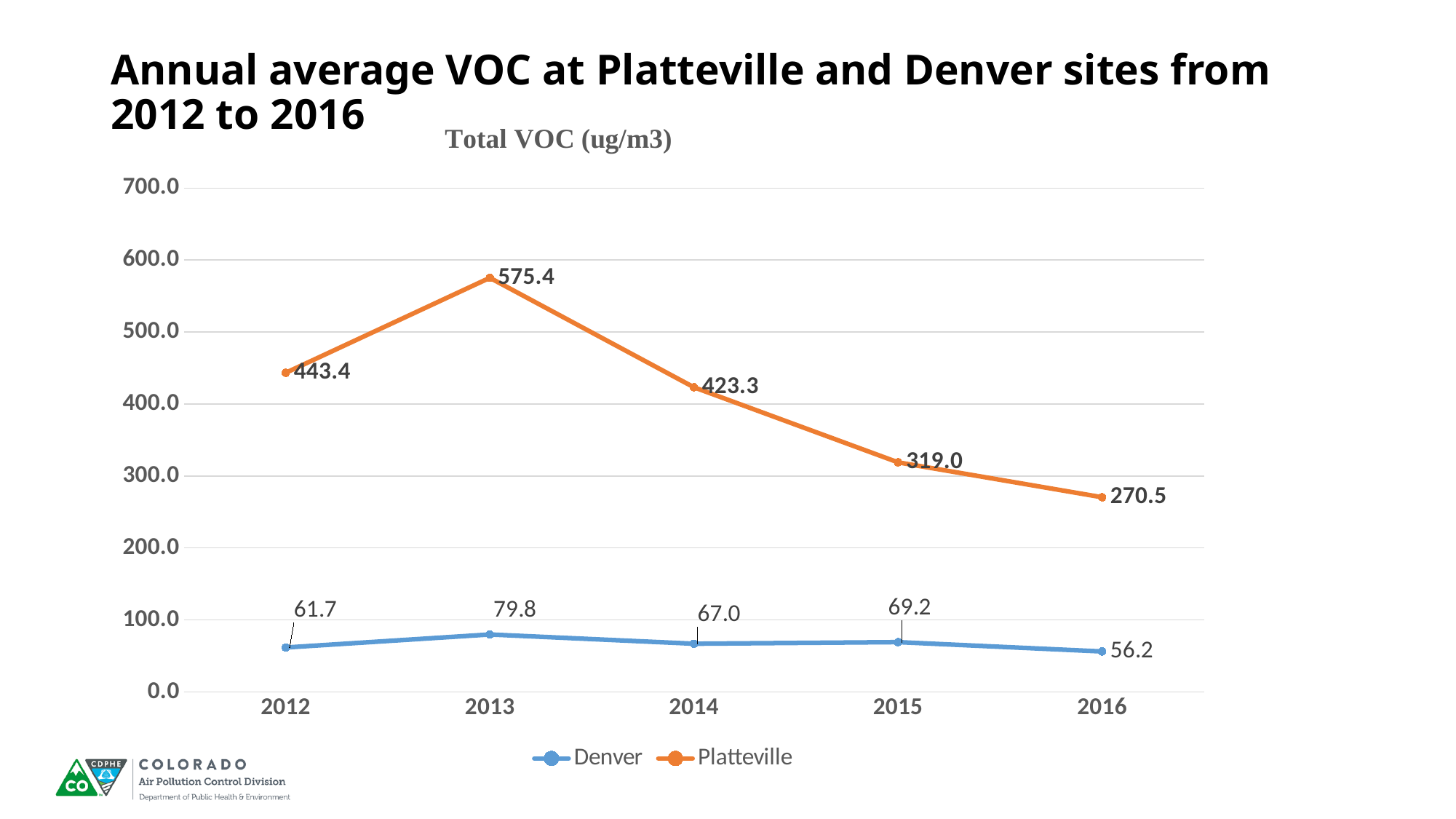
How many series does the legend list? 2 What is the Platteville value in 2016? 270.5 What is the difference between the Platteville values in 2013 and 2016? 304.9 What kind of chart is shown? line chart In which year is the Denver value lowest? 2016 Does the Platteville series rise or fall from 2013 to 2016? fall What is the Platteville value in 2013? 575.4 What is the Denver value in 2016? 56.2 How many years are plotted on the x axis? 5 What is the difference between the Platteville and Denver values in 2012? 381.7 In which year is the Platteville value highest? 2013 Which is larger, the Denver value in 2013 or the Denver value in 2015? 2013